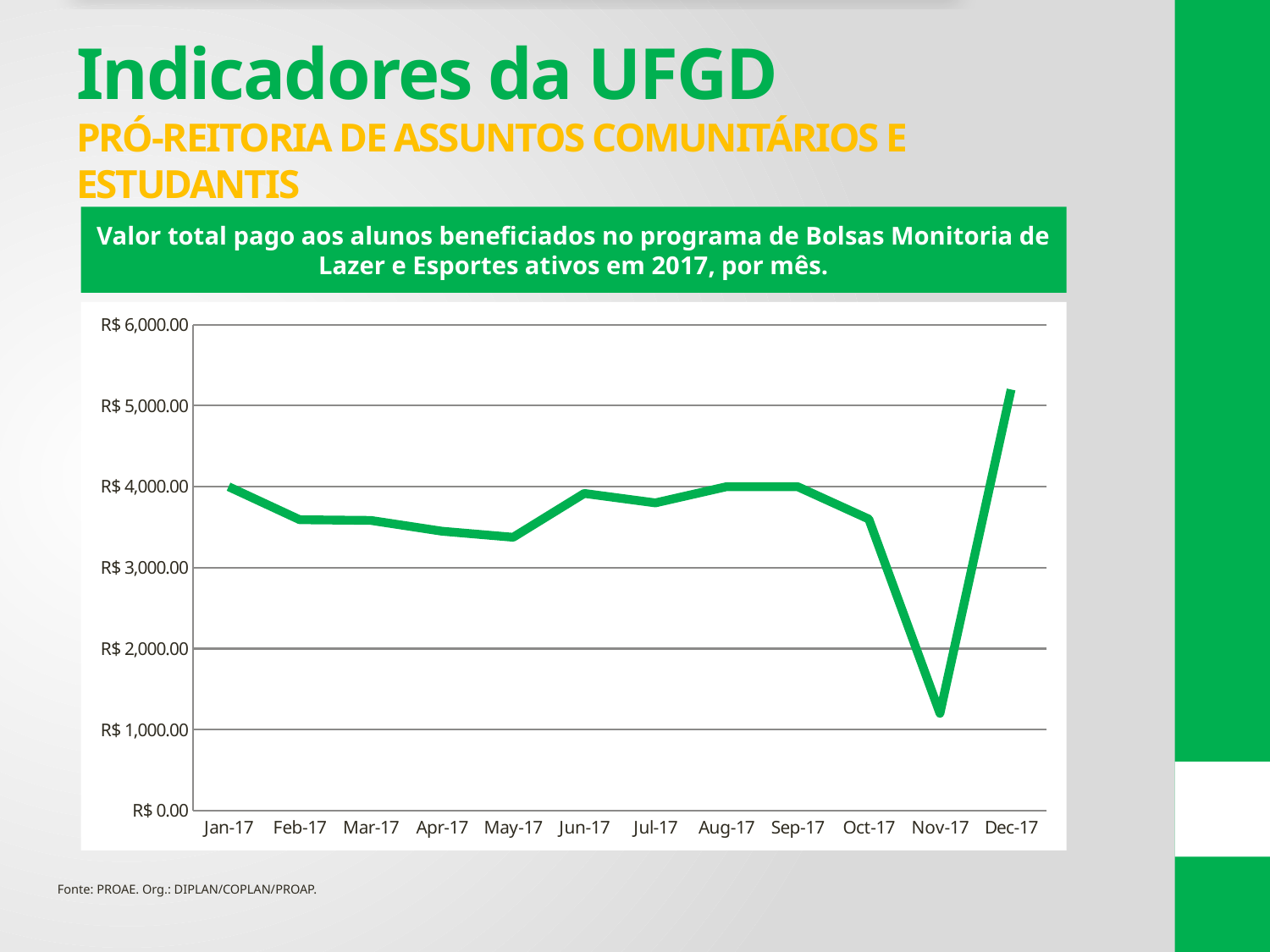
Is the value for Oct-17 greater or less than R$ 3,000.00? greater What kind of chart is shown on the slide? Line chart Which is larger, the value for Feb-17 or the value for Nov-17? Feb-17 Which month has the lowest value in the chart? Nov-17 How many months are plotted on the x axis of the chart? 12 Which month has the highest value in the chart? Dec-17 Is the value for May-17 greater or less than R$ 4,000.00? less Is the value for Nov-17 greater or less than R$ 2,000.00? less Which is larger, the value for Jun-17 or the value for May-17? Jun-17 Do the values rise or fall from Sep-17 to Nov-17? fall What is the title of the chart? Valor total pago aos alunos beneficiados no programa de Bolsas Monitoria de Lazer e Esportes ativos em 2017, por mês.